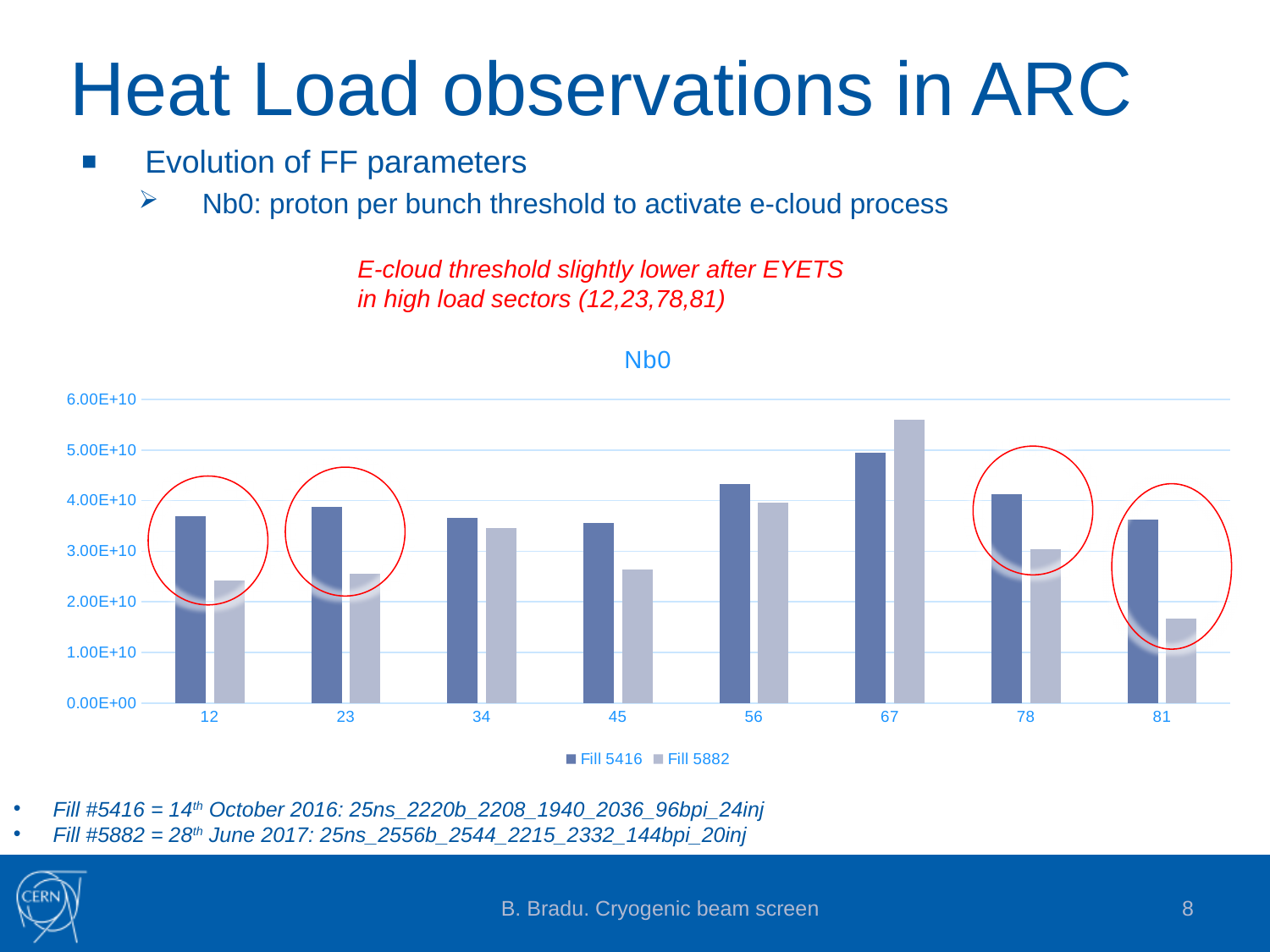
Which series are listed in the chart legend? Fill 5416 and Fill 5882 Is the Fill 5882 value for sector 81 greater or less than 2.00E+10? less For sector 12, which series has the larger value, Fill 5416 or Fill 5882? Fill 5416 For which sector is the Fill 5416 value highest? 67 For sector 67, which series has the larger value, Fill 5416 or Fill 5882? Fill 5882 How many sector categories are shown on the x axis of the chart? 8 What is the title of the chart? Nb0 For which sector is the Fill 5882 value lowest? 81 What kind of chart is shown on the slide? bar chart Is the Fill 5882 value for sector 67 greater or less than 5.00E+10? greater How many series does the chart legend list? 2 For which sector is the Fill 5882 value highest? 67